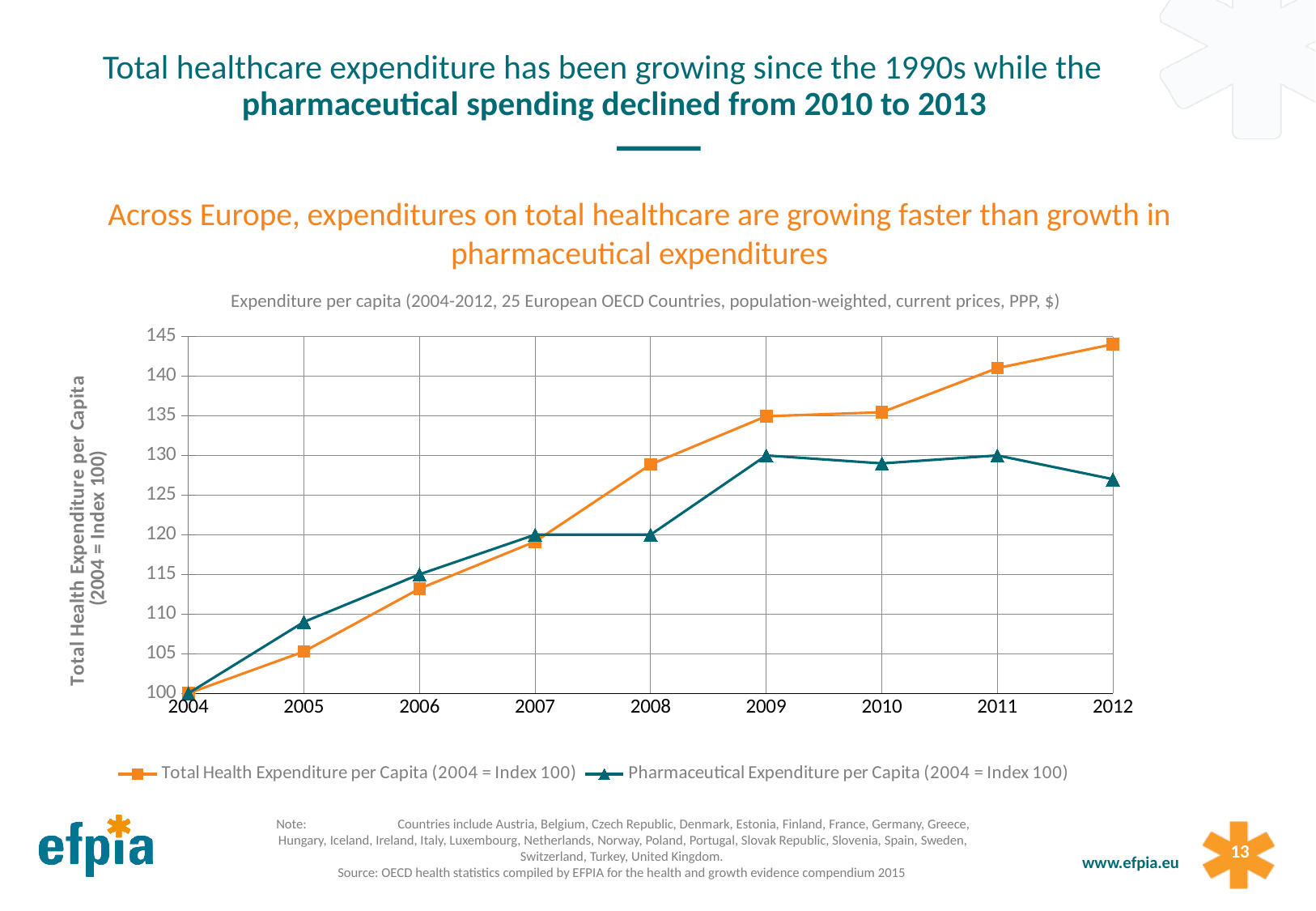
What is the value of Total Health Expenditure per Capita in 2004? 100 Is the value for Pharmaceutical Expenditure per Capita in 2012 greater or less than 130? less How many years are plotted along the x axis? 9 Is the value for Total Health Expenditure per Capita in 2012 greater or less than 140? greater In 2012, which series has the higher value: Total Health Expenditure per Capita or Pharmaceutical Expenditure per Capita? Total Health Expenditure per Capita What kind of chart is shown on the slide? line chart What is the title of the chart? Expenditure per capita (2004-2012, 25 European OECD Countries, population-weighted, current prices, PPP, $) Does Total Health Expenditure per Capita rise or fall from 2004 to 2012? rise In which year is Total Health Expenditure per Capita highest? 2012 In 2005, which series has the higher value: Total Health Expenditure per Capita or Pharmaceutical Expenditure per Capita? Pharmaceutical Expenditure per Capita How many series does the legend list? 2